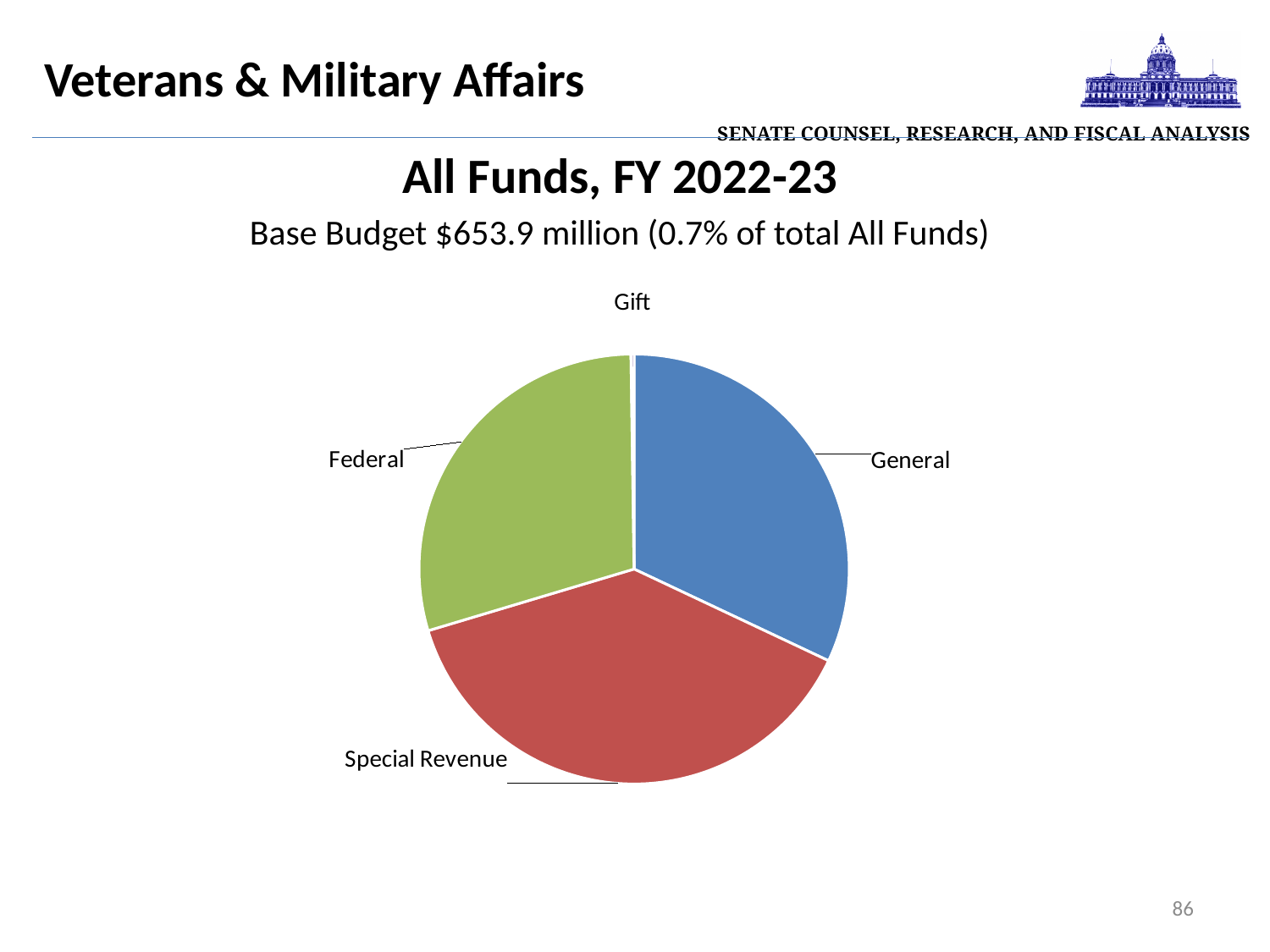
How many slices does the pie chart have? 4 Which fund has the smallest slice of the pie chart? Gift Which slice is larger, General or Gift? General What base budget amount is stated above the pie chart? $653.9 million What kind of chart is shown on the slide? pie chart Which fund has the largest slice of the pie chart? Special Revenue What is the title of the pie chart? All Funds, FY 2022-23 Which slice is larger, Special Revenue or General? Special Revenue Which slice is larger, Special Revenue or Gift? Special Revenue